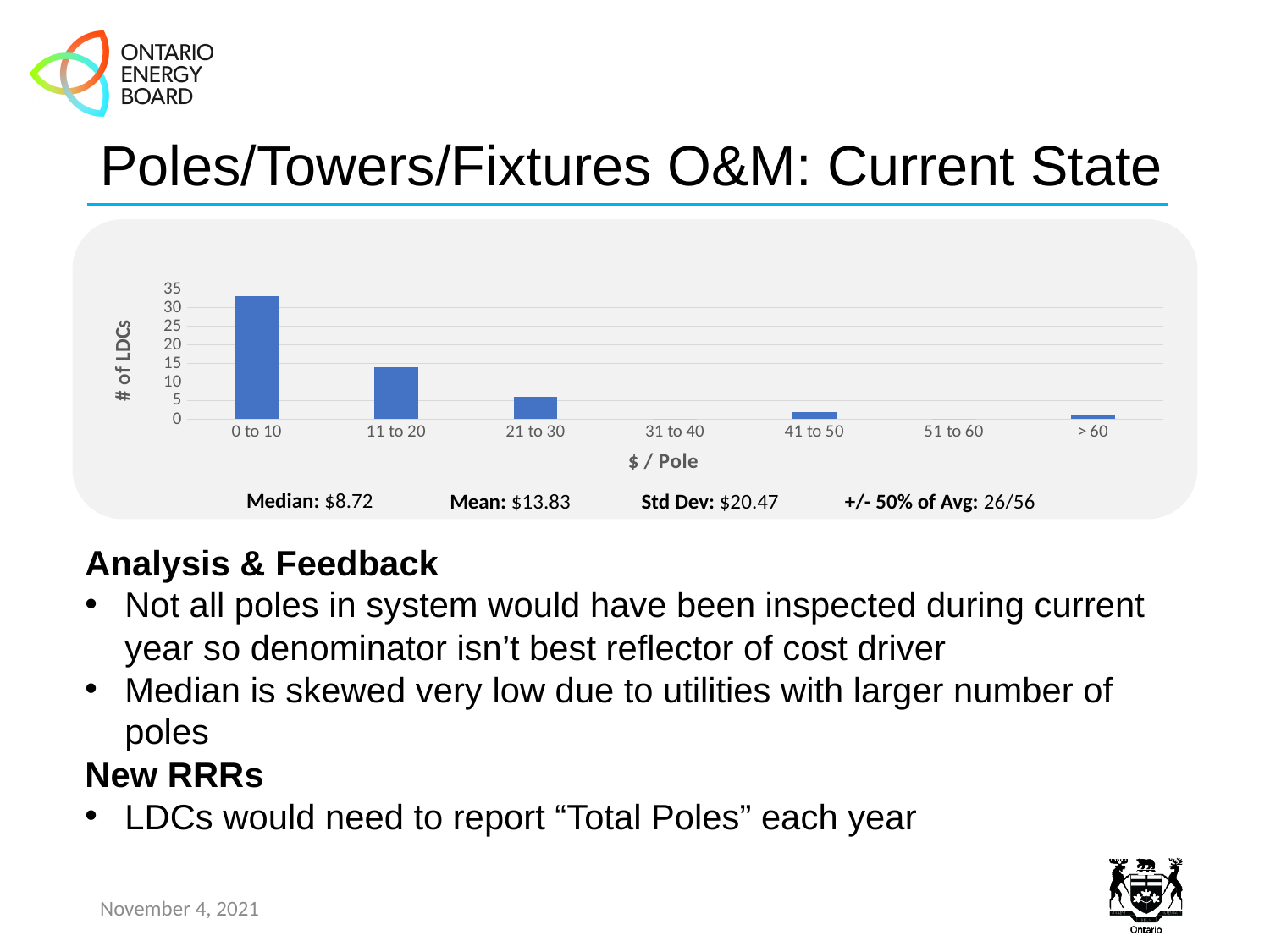
Is the number of LDCs in the 21 to 30 category greater or less than 10? less How many $ / Pole categories are shown on the x axis of the chart? 7 What kind of chart is shown on the slide? bar chart What is the label of the x axis of the chart? $ / Pole Which has more LDCs, the 0 to 10 category or the 11 to 20 category? 0 to 10 Which $ / Pole category has the highest number of LDCs? 0 to 10 Do the bar heights generally rise or fall as $ / Pole increases from 0 to 10 through 21 to 30? fall Is the number of LDCs in the 11 to 20 category greater or less than 10? greater Is the number of LDCs in the 41 to 50 category greater or less than 5? less What is the label of the y axis of the chart? # of LDCs Which has more LDCs, the 21 to 30 category or the 41 to 50 category? 21 to 30